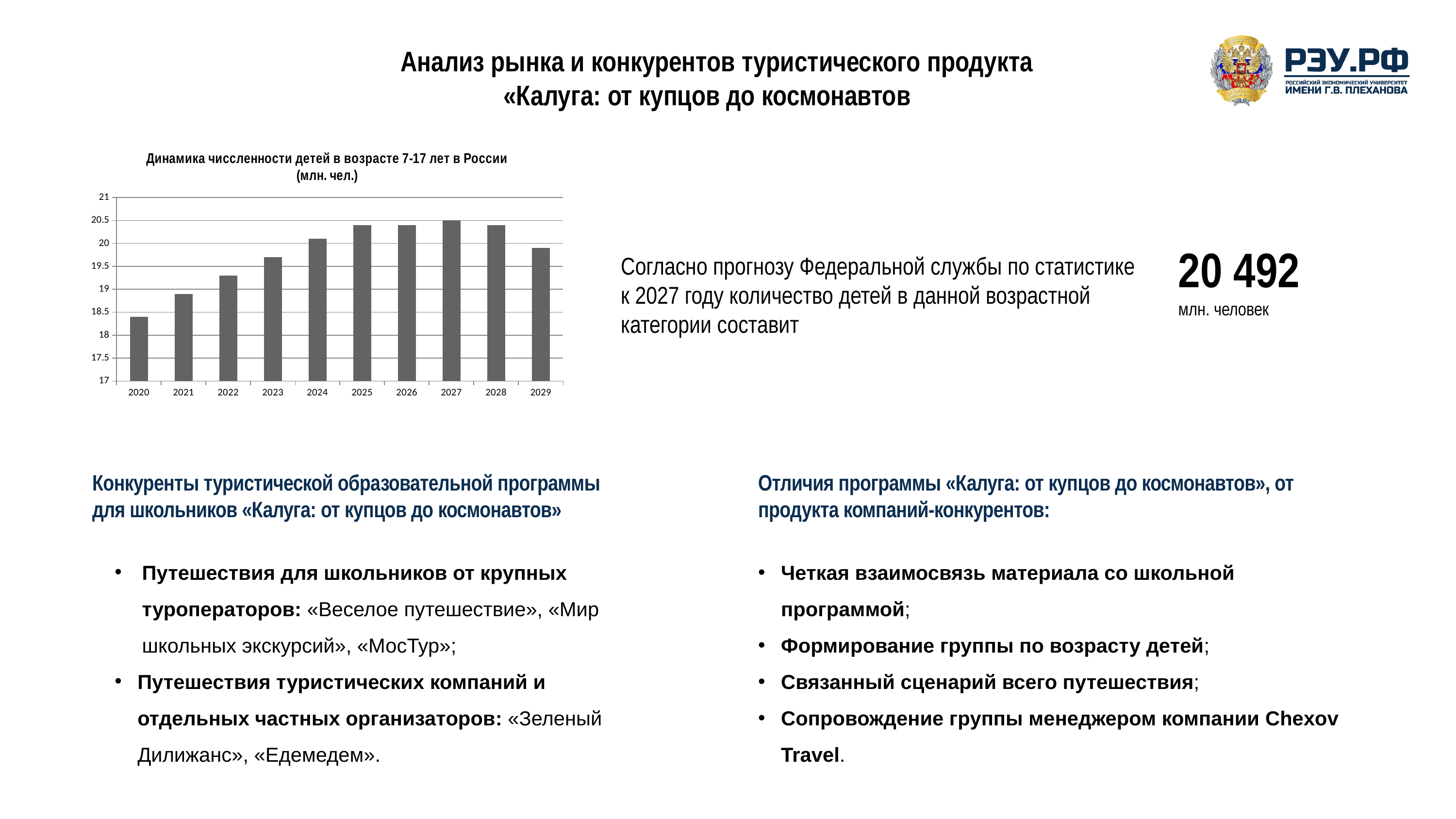
How many years are shown on the x axis of the chart? 10 Is the value for 2023 greater or less than 20? less Is the value for 2020 greater or less than 19? less Which year has the larger value, 2020 or 2029? 2029 Is the value for 2022 greater or less than 19? greater Which year has the larger value, 2022 or 2028? 2028 What unit is given in the chart title? млн. чел. Do the values rise or fall from 2020 to 2024? rise Which year has the lowest value in the chart? 2020 What kind of chart is shown on the slide? bar chart